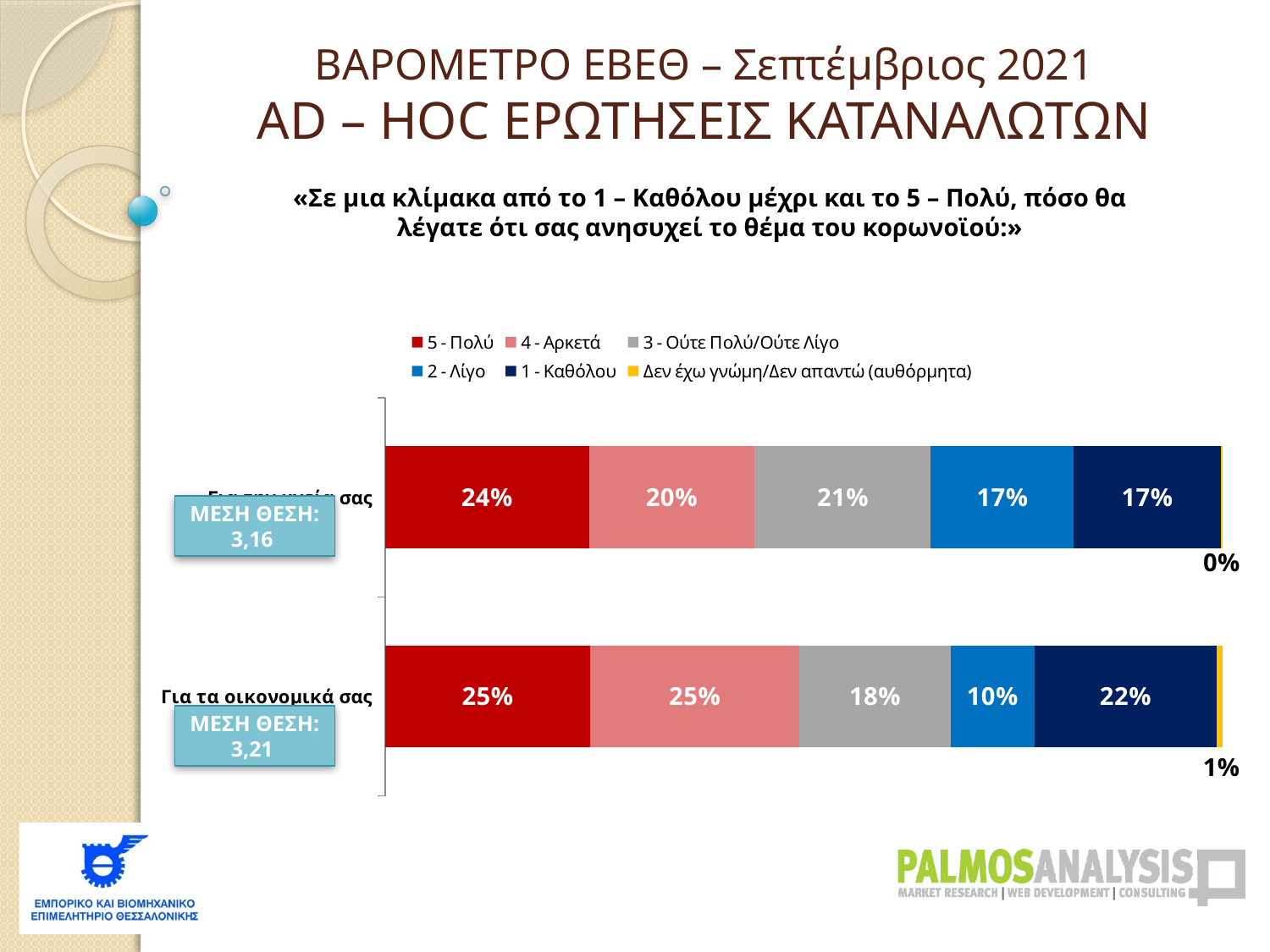
What is the ΜΕΣΗ ΘΕΣΗ value shown for "Για τα οικονομικά σας"? 3,21 What percentage is shown for "Δεν έχω γνώμη/Δεν απαντώ (αυθόρμητα)" in the "Για τα οικονομικά σας" bar? 1% What is the value of the "2 - Λίγο" segment in the "Για τα οικονομικά σας" bar? 10% In the top bar of the chart, what is the value of the "1 - Καθόλου" segment? 17% What percentage of respondents answered "5 - Πολύ" for "Για τα οικονομικά σας"? 25% How many series does the legend list? 6 In the top bar of the chart, what is the value of the "3 - Ούτε Πολύ/Ούτε Λίγο" segment? 21% Which segment is the largest in the top bar of the chart? 5 - Πολύ How many bars are plotted in the chart? 2 Which bar has the larger "2 - Λίγο" share, the top bar or "Για τα οικονομικά σας"? The top bar What kind of chart is shown on the slide? Stacked bar chart How many percentage points higher is the "1 - Καθόλου" share for "Για τα οικονομικά σας" than for the top bar? 5 percentage points